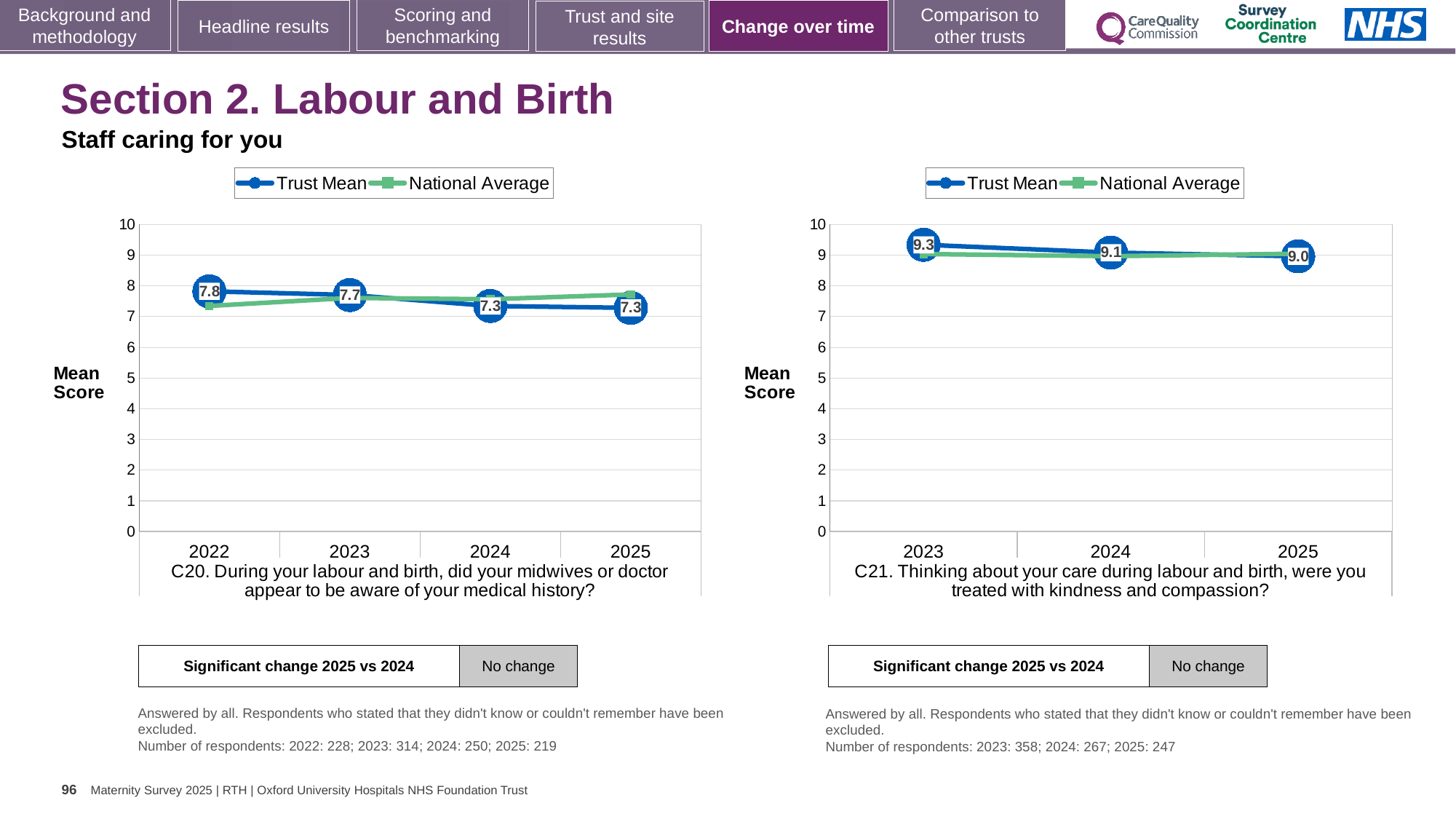
On the left chart (C20), what is the Trust Mean score for 2022? 7.8 On the right chart (C21), what is the difference between the Trust Mean scores for 2023 and 2025? 0.3 How many series does the legend of the right chart (C21) list? 2 On the right chart (C21), which year has the lowest Trust Mean score? 2025 What kind of chart is the left chart (C20)? line chart On the left chart (C20), what is the difference between the Trust Mean scores for 2022 and 2025? 0.5 On the left chart (C20), what is the Trust Mean score for 2025? 7.3 How many years are plotted on the left chart (C20)? 4 On the right chart (C21), does the Trust Mean score rise or fall from 2023 to 2025? fall On the left chart (C20), which year has the highest Trust Mean score? 2022 On the right chart (C21), what is the Trust Mean score for 2023? 9.3 On the right chart (C21), what is the Trust Mean score for 2025? 9.0